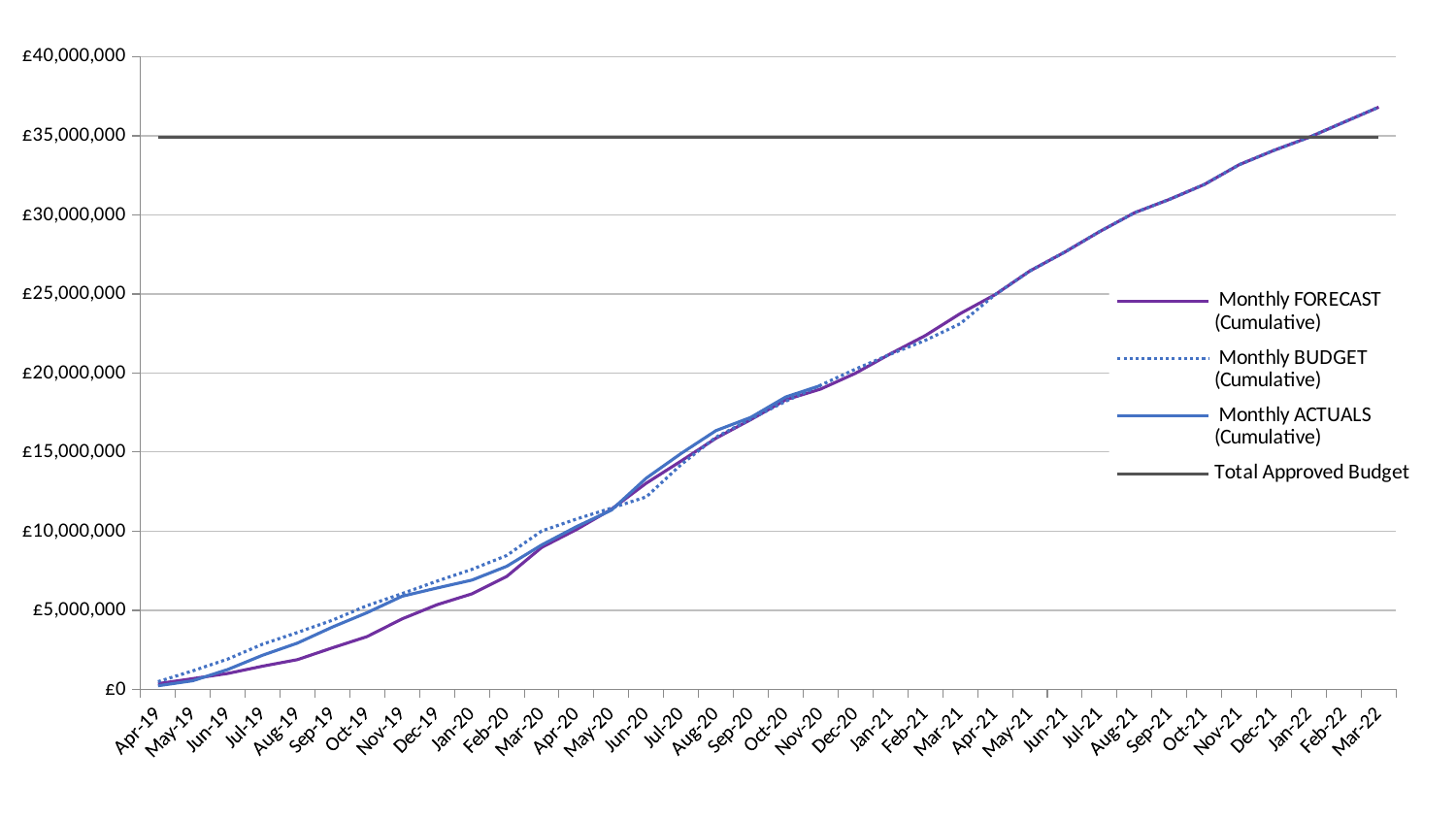
What kind of chart is shown on the slide? line chart Is the value of Monthly ACTUALS (Cumulative) at Aug-20 greater or less than £15,000,000? greater Is the value of Monthly FORECAST (Cumulative) at Sep-21 greater or less than £30,000,000? greater Is the value of Monthly FORECAST (Cumulative) at Nov-19 greater or less than £5,000,000? less Which series is drawn as a dotted line? Monthly BUDGET (Cumulative) How many months are shown along the x axis? 36 At Jan-20, which is higher: Monthly ACTUALS (Cumulative) or Monthly FORECAST (Cumulative)? Monthly ACTUALS (Cumulative) How many series does the legend list? 4 At Aug-19, which is higher: Monthly BUDGET (Cumulative) or Monthly FORECAST (Cumulative)? Monthly BUDGET (Cumulative) Does the Monthly FORECAST (Cumulative) line rise or fall from Apr-19 to Mar-22? rise